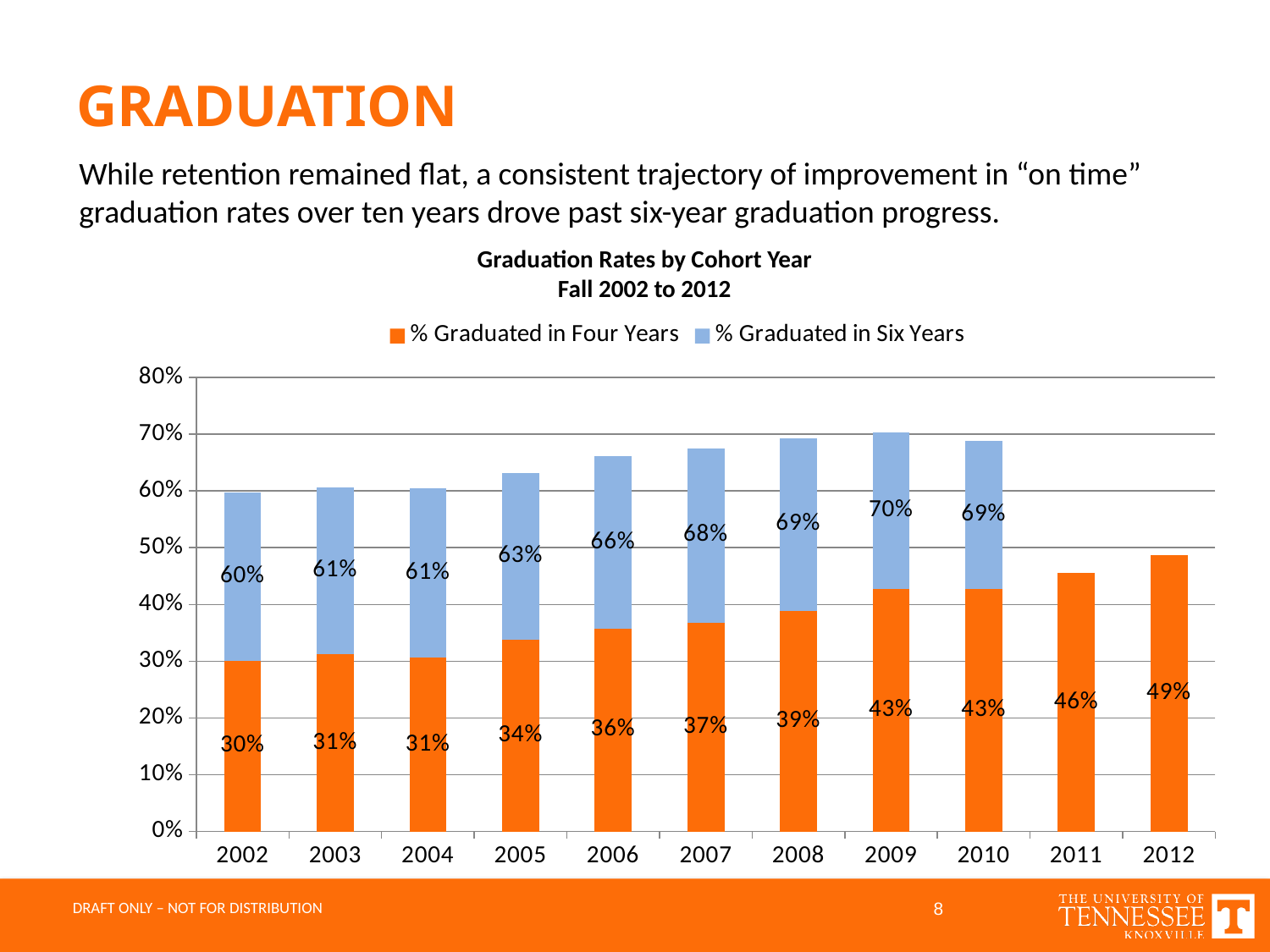
Which cohort year has the highest % Graduated in Four Years? 2012 Which is larger, the % Graduated in Four Years for 2008 or for 2011? 2011 Which cohort year has the lowest % Graduated in Four Years? 2002 What is the difference between the % Graduated in Four Years for 2012 and 2002? 19% What kind of chart is shown on the slide? Stacked bar chart Do the % Graduated in Four Years values generally rise or fall from 2002 to 2012? Rise What is the % Graduated in Six Years value labeled for 2009? 70% What is the % Graduated in Four Years value for 2005? 34% Is the % Graduated in Four Years for 2009 greater or less than 40%? greater How many series does the legend list? 2 What is the % Graduated in Four Years value for 2012? 49% How many cohort years are shown on the x axis? 11